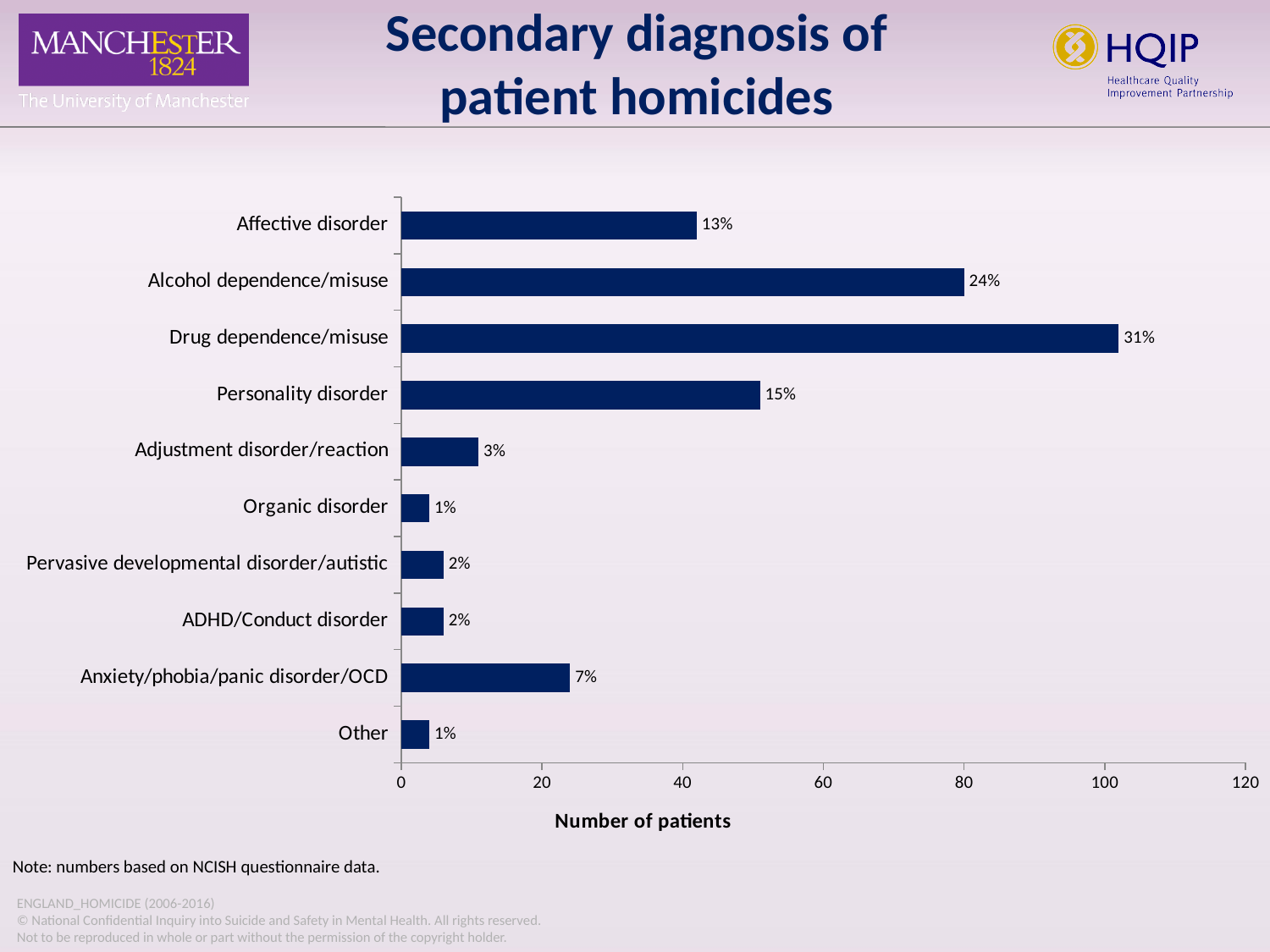
How many percentage points higher is the label for Drug dependence/misuse than for Alcohol dependence/misuse? 7 What is the title of the horizontal axis? Number of patients Is the number of patients for Drug dependence/misuse greater or less than 100? greater What type of chart is shown on the slide? Bar chart Which secondary diagnosis has the longest bar? Drug dependence/misuse How many secondary diagnosis categories are shown in the chart? 10 Which has the larger value, Affective disorder or Personality disorder? Personality disorder What percentage label is shown for Alcohol dependence/misuse? 24% What percentage label is shown for Anxiety/phobia/panic disorder/OCD? 7% Is the number of patients for Affective disorder greater or less than 40? greater Is the number of patients for Personality disorder greater or less than 60? less What percentage label is shown for Drug dependence/misuse? 31%